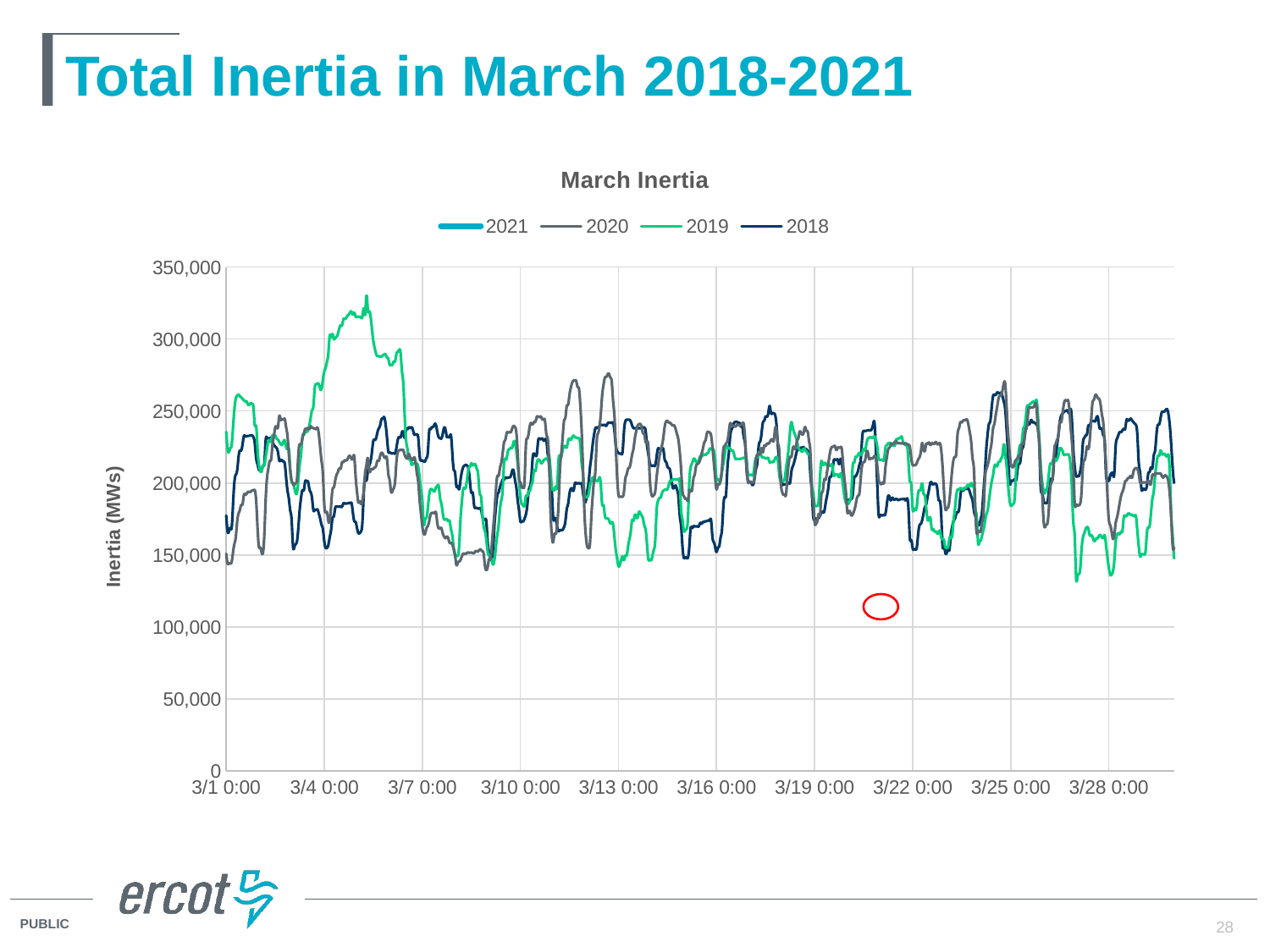
How many date labels are shown on the x-axis of the March Inertia chart? 10 Is the lowest value of the 2019 series greater or less than 100,000? greater What is the title of the chart on the slide? March Inertia Is the highest value of the 2018 series greater or less than 300,000? less How many series does the legend of the March Inertia chart list? 4 Is the highest value of the 2020 series greater or less than 250,000? greater What kind of chart is shown on the slide? Line chart What is the highest value shown on the y-axis of the March Inertia chart? 350,000 What is the first date label on the x-axis of the March Inertia chart? 3/1 0:00 Which series reaches the highest value on the March Inertia chart? 2019 What is the label of the y-axis on the March Inertia chart? Inertia (MWs)